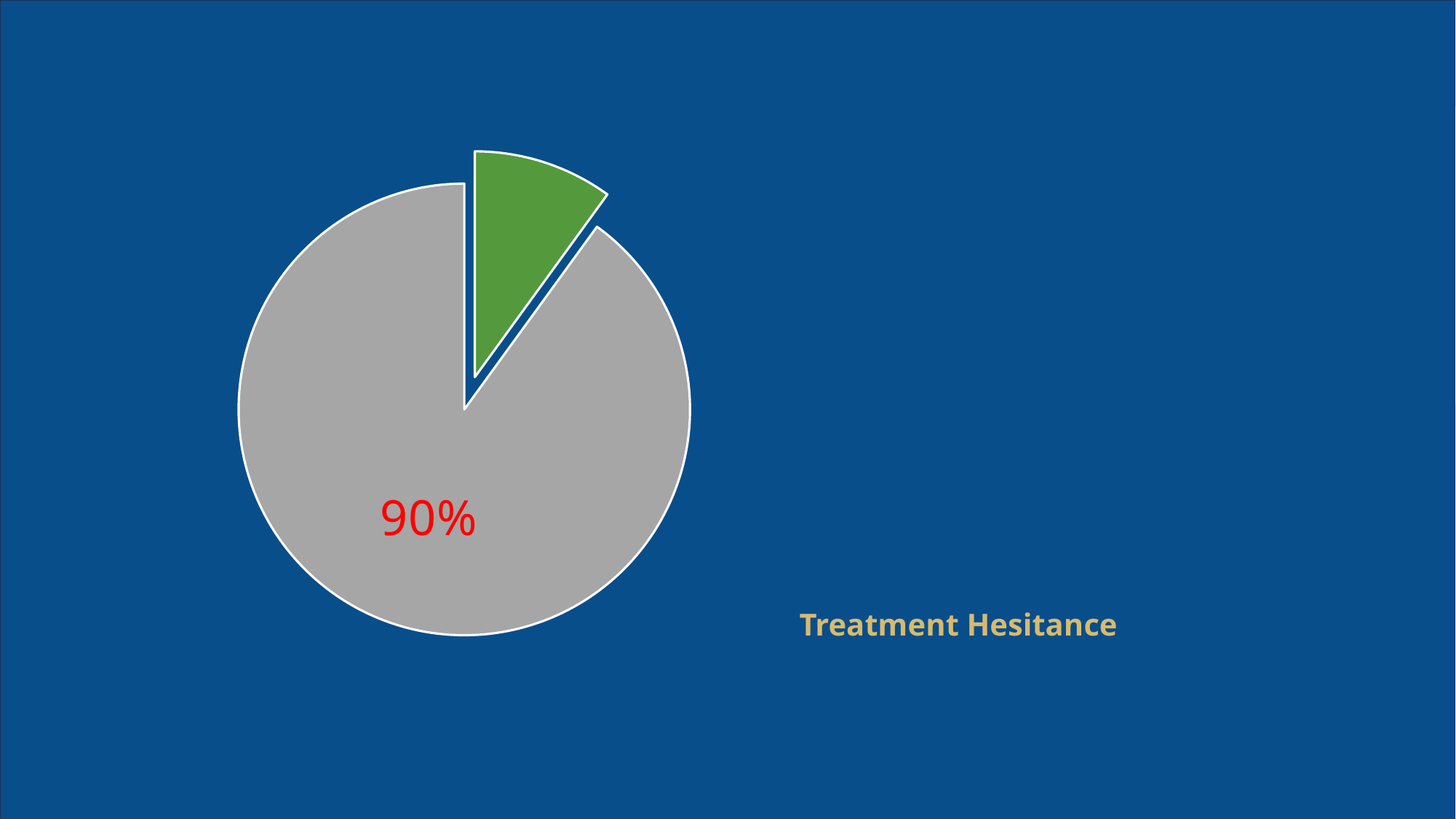
Which slice of the pie chart is the largest, the grey one or the green one? the grey one What kind of chart is shown on the slide? pie chart Which slice of the pie chart is the smallest, the grey one or the green one? the green one What colour is the slice that is pulled out from the pie chart? green What text appears to the right of the pie chart? Treatment Hesitance Is the green slice of the pie chart larger or smaller than the grey slice? smaller How many slices does the pie chart have? 2 What value is printed on the grey slice of the pie chart? 90% Is the share of the green slice greater or less than 50%? less